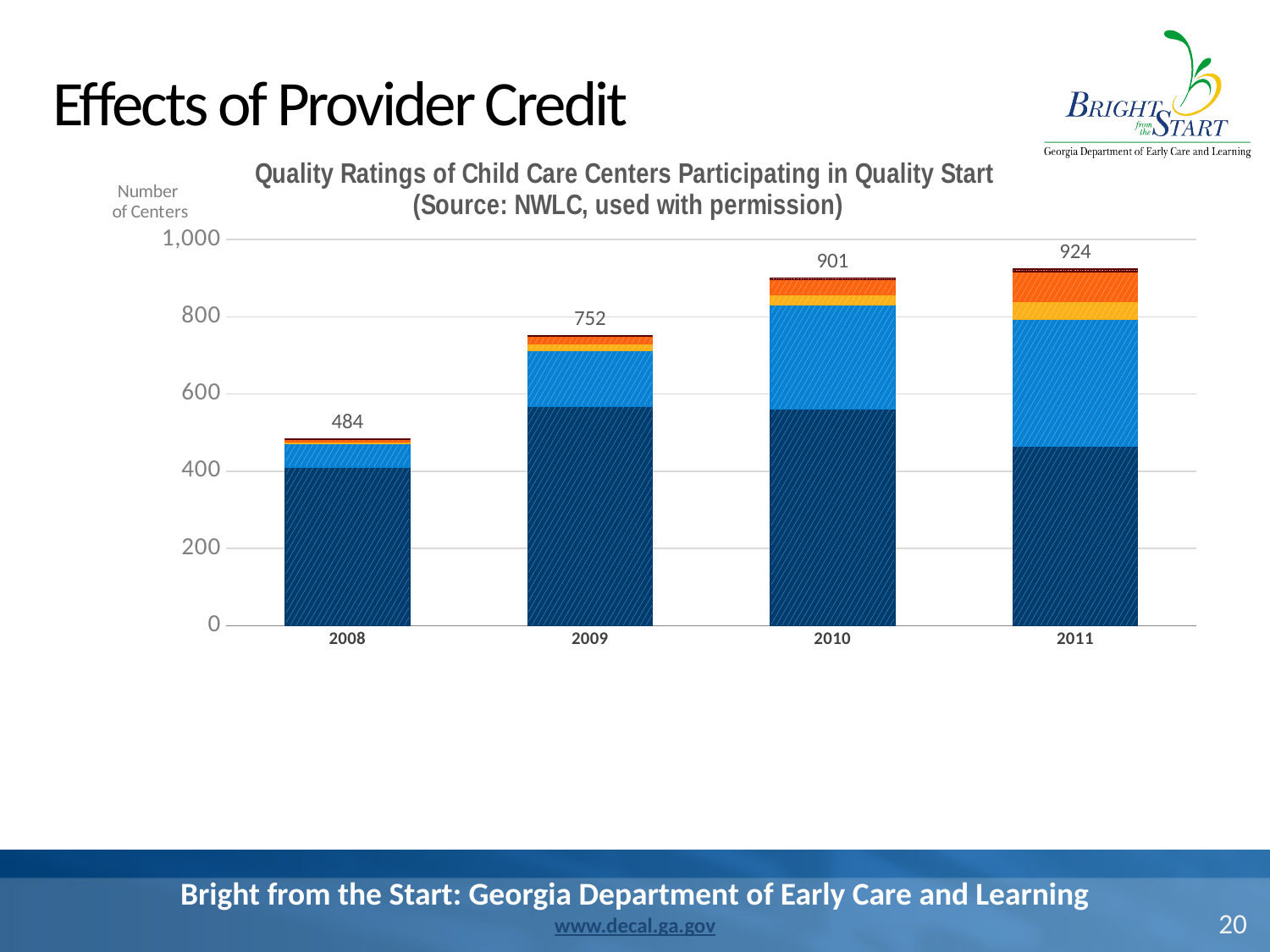
What is the difference between the total number of centers in 2011 and in 2008? 440 Which year has the lowest total number of centers? 2008 Do the total numbers of centers rise or fall from 2008 to 2011? Rise Is the dark blue bottom segment for 2009 greater or less than 600? less Which year has the highest total number of centers? 2011 What is the total number of centers shown for 2008? 484 Which year has a larger total number of centers, 2009 or 2010? 2010 What is the total number of centers shown for 2009? 752 What is the total number of centers shown for 2011? 924 What kind of chart is shown on the slide? Stacked bar chart How many years are shown on the x axis? 4 What is the total number of centers shown for 2010? 901